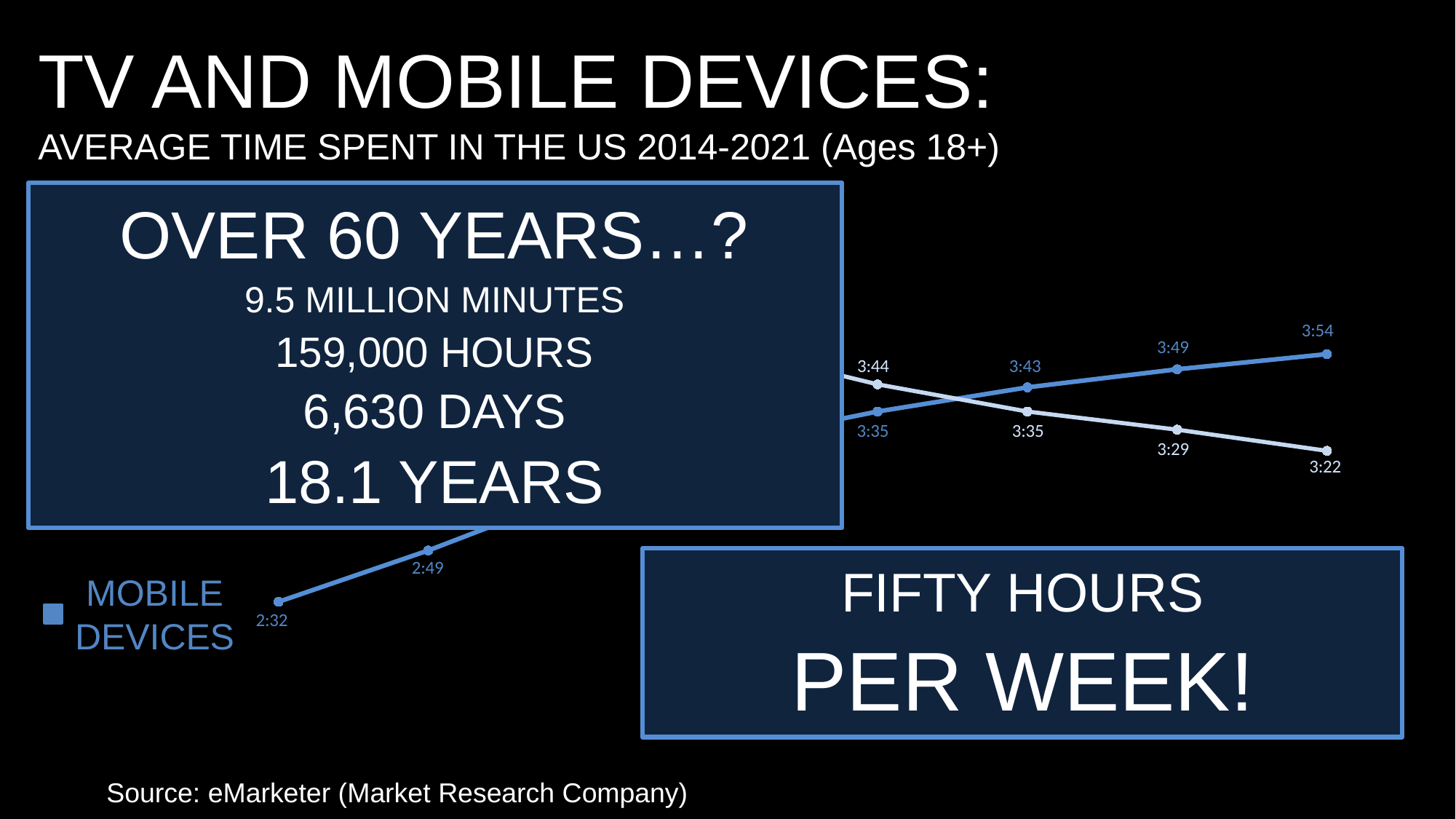
Does the MOBILE DEVICES line rise or fall from left to right? rises What is the highest labelled value visible on the lighter line? 3:44 What colour is the MOBILE DEVICES line? blue What is the highest labelled value on the MOBILE DEVICES line? 3:54 At the rightmost data point, which line is higher: the MOBILE DEVICES line or the lighter line? MOBILE DEVICES What kind of chart is shown on the slide? line chart Which legend entry is readable on the slide? MOBILE DEVICES Does the lighter (non-mobile) line rise or fall from left to right? falls What is the lowest labelled value on the MOBILE DEVICES line? 2:32 Which of the two lines is higher at the point where the lighter line is labelled 3:44 and the MOBILE DEVICES line is labelled 3:35? the lighter line What is the lowest labelled value on the lighter line? 3:22 At the rightmost data point, how much higher is the MOBILE DEVICES value (3:54) than the lighter line's value (3:22)? 32 minutes